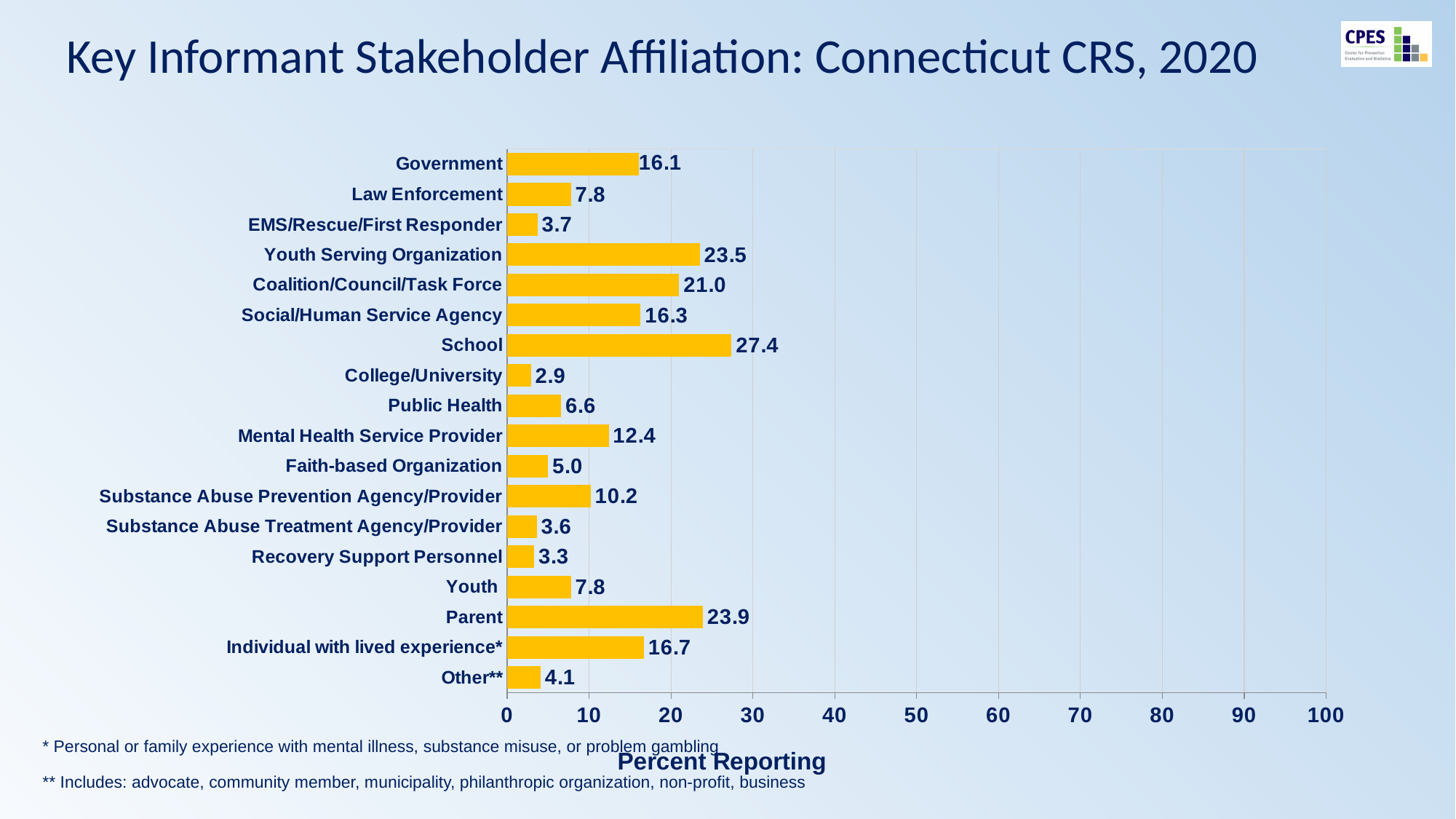
What is the value for School? 27.4 What is the difference between the values for Parent and Youth Serving Organization? 0.4 What is the label of the horizontal axis? Percent Reporting Which is larger, the value for Coalition/Council/Task Force or the value for Social/Human Service Agency? Coalition/Council/Task Force How many categories are shown in the chart? 18 What kind of chart is shown on the slide? bar chart Which category has the lowest value? College/University What is the difference between the values for Government and Law Enforcement? 8.3 What is the value for Mental Health Service Provider? 12.4 What is the value for Individual with lived experience*? 16.7 Is the value for Substance Abuse Prevention Agency/Provider greater or less than 20? less Which category has the highest value? School